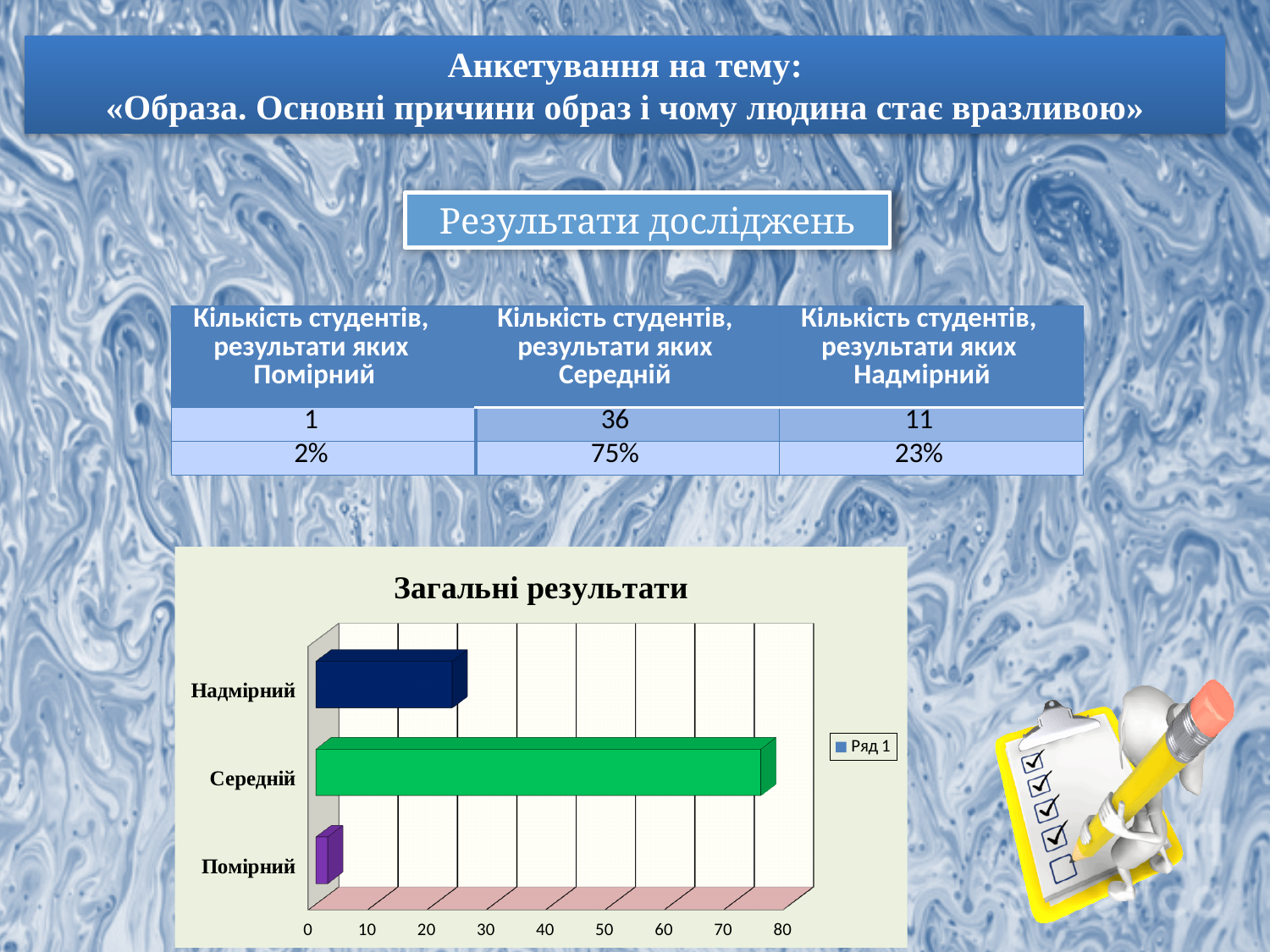
Which has the larger value in the chart, Надмірний or Помірний? Надмірний Which category has the highest value in the chart? Середній What kind of chart is shown on the slide? bar chart How many series does the chart legend list? 1 Is the value for Середній greater or less than 70? greater Which has the larger value in the chart, Середній or Надмірний? Середній Which category has the lowest value in the chart? Помірний What is the name of the series shown in the chart legend? Ряд 1 Is the value for Надмірний greater or less than 30? less Is the value for Помірний greater or less than 10? less How many categories are plotted in the chart? 3 What is the title of the chart? Загальні результати